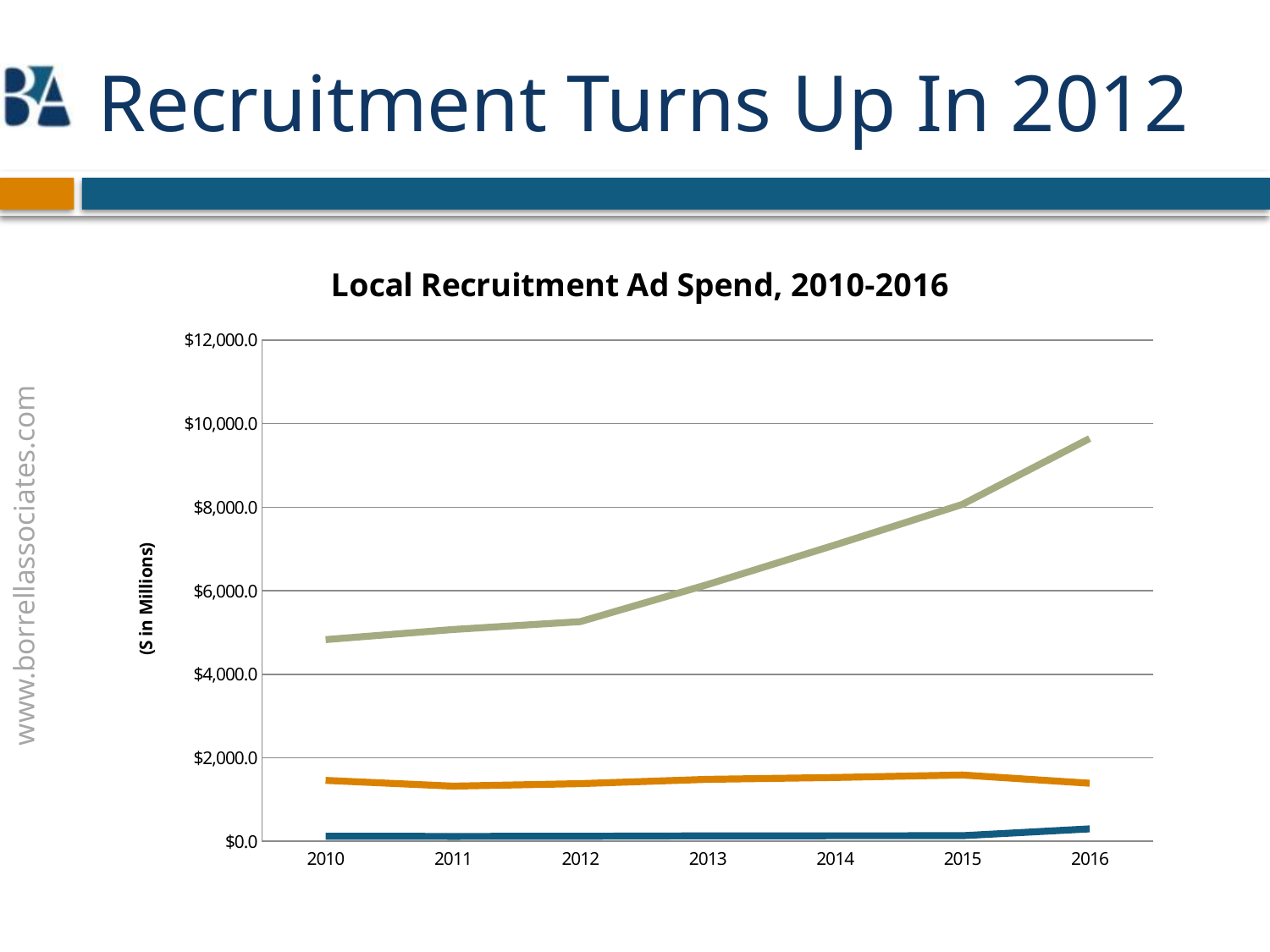
In which year is the grey (top) line at its lowest value? 2010 Does the grey (top) line rise or fall from 2010 to 2016? Rise Is the value of the grey (top) line in 2016 greater or less than $8,000.0? greater Is the value of the grey (top) line in 2010 greater or less than $6,000.0? less In which year does the grey (top) line reach its highest value? 2016 What is the label on the vertical axis of the chart? ($ in Millions) What type of chart is shown on the slide? Line chart How many lines are plotted on the chart? 3 How many years are shown along the x axis of the chart? 7 What is the title of the chart? Local Recruitment Ad Spend, 2010-2016 Is the value of the orange (middle) line in 2010 greater or less than $2,000.0? less In 2016, which line has the larger value, the grey line or the orange line? The grey line